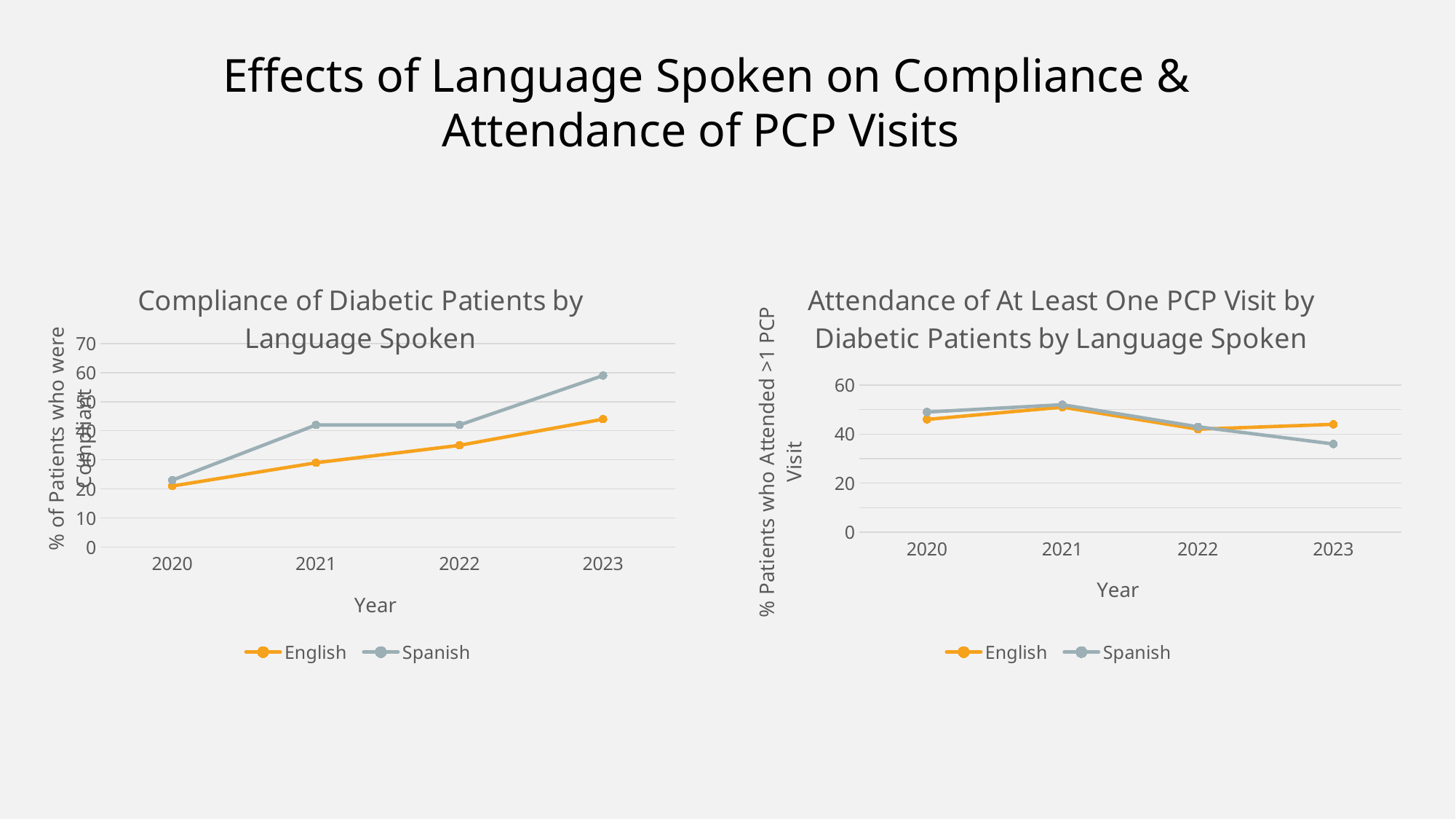
In the 'Attendance of At Least One PCP Visit by Diabetic Patients by Language Spoken' chart, is the Spanish value for 2023 greater or less than 40? less In the 'Compliance of Diabetic Patients by Language Spoken' chart, in which year is the Spanish series highest? 2023 In the 'Attendance of At Least One PCP Visit by Diabetic Patients by Language Spoken' chart, which series has the higher value in 2023, English or Spanish? English What is the x-axis label of the 'Attendance of At Least One PCP Visit by Diabetic Patients by Language Spoken' chart? Year In the 'Compliance of Diabetic Patients by Language Spoken' chart, which series has the higher value in 2022, English or Spanish? Spanish In the 'Compliance of Diabetic Patients by Language Spoken' chart, is the Spanish value for 2023 greater or less than 50? greater How many years are shown on the x axis of the 'Compliance of Diabetic Patients by Language Spoken' chart? 4 In the 'Compliance of Diabetic Patients by Language Spoken' chart, does the English series rise or fall from 2020 to 2023? rise In the 'Attendance of At Least One PCP Visit by Diabetic Patients by Language Spoken' chart, in which year is the Spanish series lowest? 2023 How many series does the legend of the 'Attendance of At Least One PCP Visit by Diabetic Patients by Language Spoken' chart list? 2 What kind of chart is the 'Compliance of Diabetic Patients by Language Spoken' chart? line chart